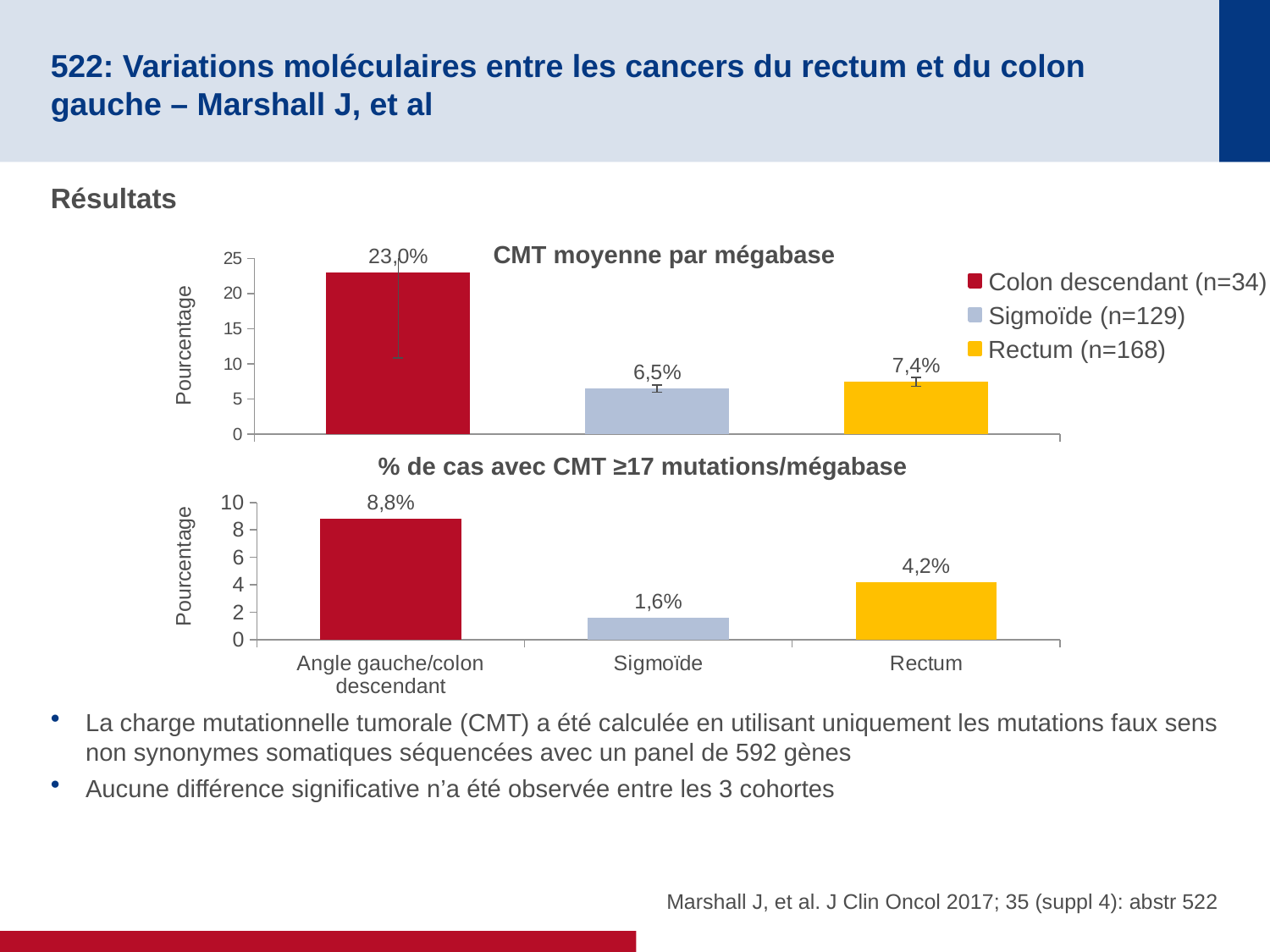
In the '% de cas avec CMT ≥17 mutations/mégabase' chart, what is the value for Sigmoïde? 1,6% In the '% de cas avec CMT ≥17 mutations/mégabase' chart, which category has the highest value? Angle gauche/colon descendant In the '% de cas avec CMT ≥17 mutations/mégabase' chart, what is the value for Rectum? 4,2% In the 'CMT moyenne par mégabase' chart, which category has the lowest value? Sigmoïde In the 'CMT moyenne par mégabase' chart, what is the value for Rectum? 7,4% In the 'CMT moyenne par mégabase' chart, what is the difference between the Colon descendant value and the Rectum value? 15,6% How many series does the legend list? 3 In the 'CMT moyenne par mégabase' chart, which is larger: the value for Rectum or the value for Sigmoïde? Rectum In the 'CMT moyenne par mégabase' chart, what is the value for Sigmoïde? 6,5% In the 'CMT moyenne par mégabase' chart, what is the value for Colon descendant? 23,0% What kind of chart is the '% de cas avec CMT ≥17 mutations/mégabase' chart? Bar chart In the '% de cas avec CMT ≥17 mutations/mégabase' chart, what is the difference between the Angle gauche/colon descendant value and the Sigmoïde value? 7,2%